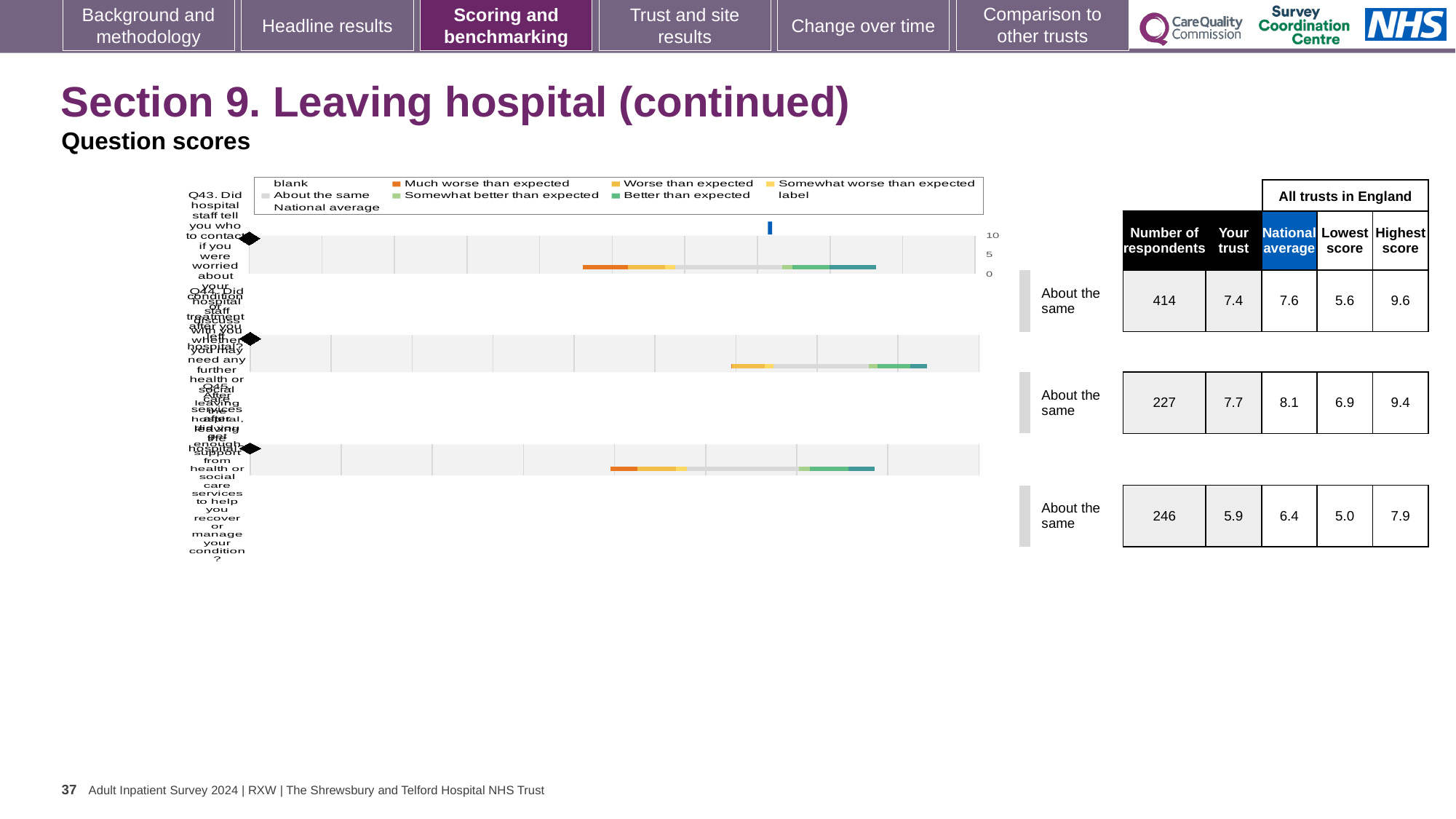
What is the difference between the highest score and the lowest score for the first question (Q43)? 4.0 For the third question (bottom row), which is larger: the 'Your trust' score or the national average? National average How many question bars are plotted in the chart? 3 What kind of chart is shown on the slide? Bar chart What is the difference between the national average and the 'Your trust' score for the second row? 0.4 What is the national average score for the first question (Q43)? 7.6 What colour does the legend use for 'Much worse than expected'? Orange What benchmark category label is shown beside each of the three bars? About the same Which row has the lowest 'Your trust' score? The third row (5.9) Which row has the highest 'Your trust' score? The second row (7.7) What is the 'Your trust' score for the first question (Q43) in the table beside the chart? 7.4 How many respondents are listed for the third question (bottom row)? 246